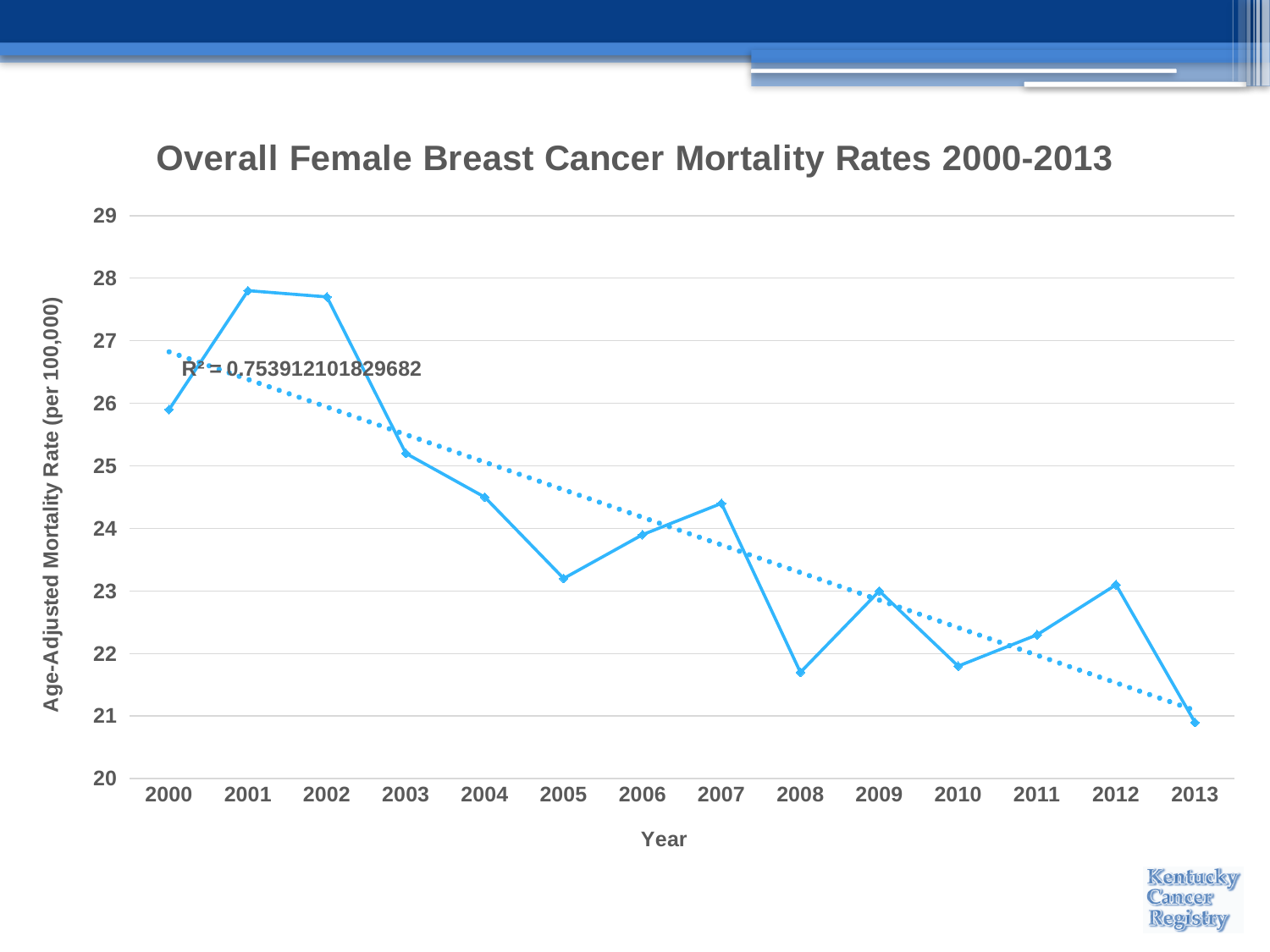
Which year has the higher mortality rate, 2000 or 2003? 2000 Which year has the higher mortality rate, 2008 or 2012? 2012 Which year has the lowest age-adjusted mortality rate? 2013 What kind of chart is shown on the slide? line chart Overall, do the mortality rates rise or fall from 2000 to 2013? fall Is the value for 2005 greater or less than 24? less Is the value for 2008 greater or less than 22? less Is the value for 2000 greater or less than 25? greater What R² value is printed on the chart for the trend line? R² = 0.753912101829682 How many years (data points) are plotted on the x axis? 14